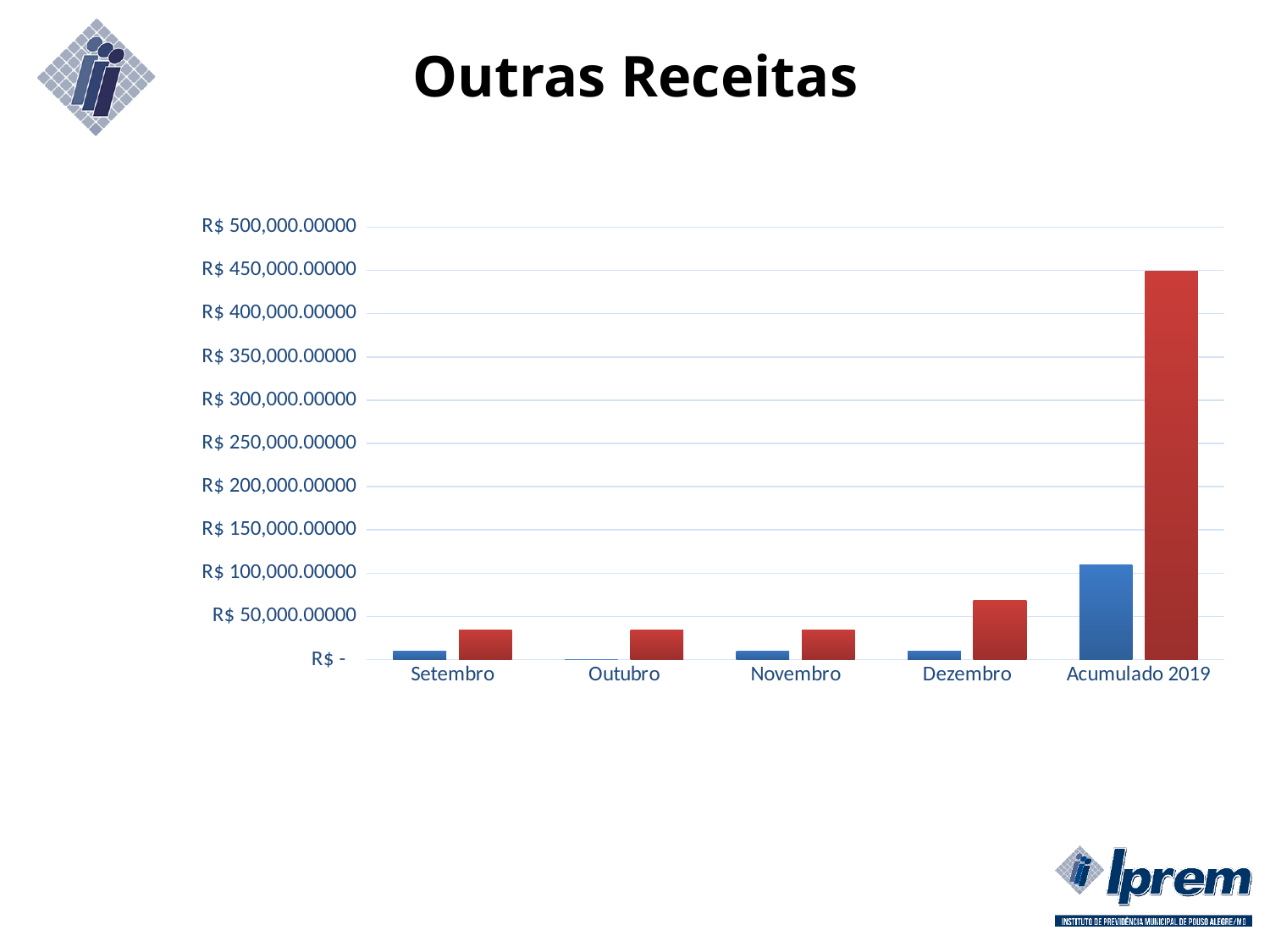
Is the red bar for Acumulado 2019 greater or less than R$ 400,000.00000? greater Which category has the tallest blue bar? Acumulado 2019 What is the highest value labelled on the y axis? R$ 500,000.00000 What is the title of the chart? Outras Receitas Is the blue bar for Acumulado 2019 greater or less than R$ 50,000.00000? greater What kind of chart is shown on the slide? bar chart Which is larger, the blue bar for Acumulado 2019 or the blue bar for Dezembro? Acumulado 2019 Which category has the tallest red bar? Acumulado 2019 Is the red bar for Dezembro greater or less than R$ 50,000.00000? greater How many categories are shown on the x axis of the chart? 5 Which is larger, the red bar for Dezembro or the red bar for Novembro? Dezembro